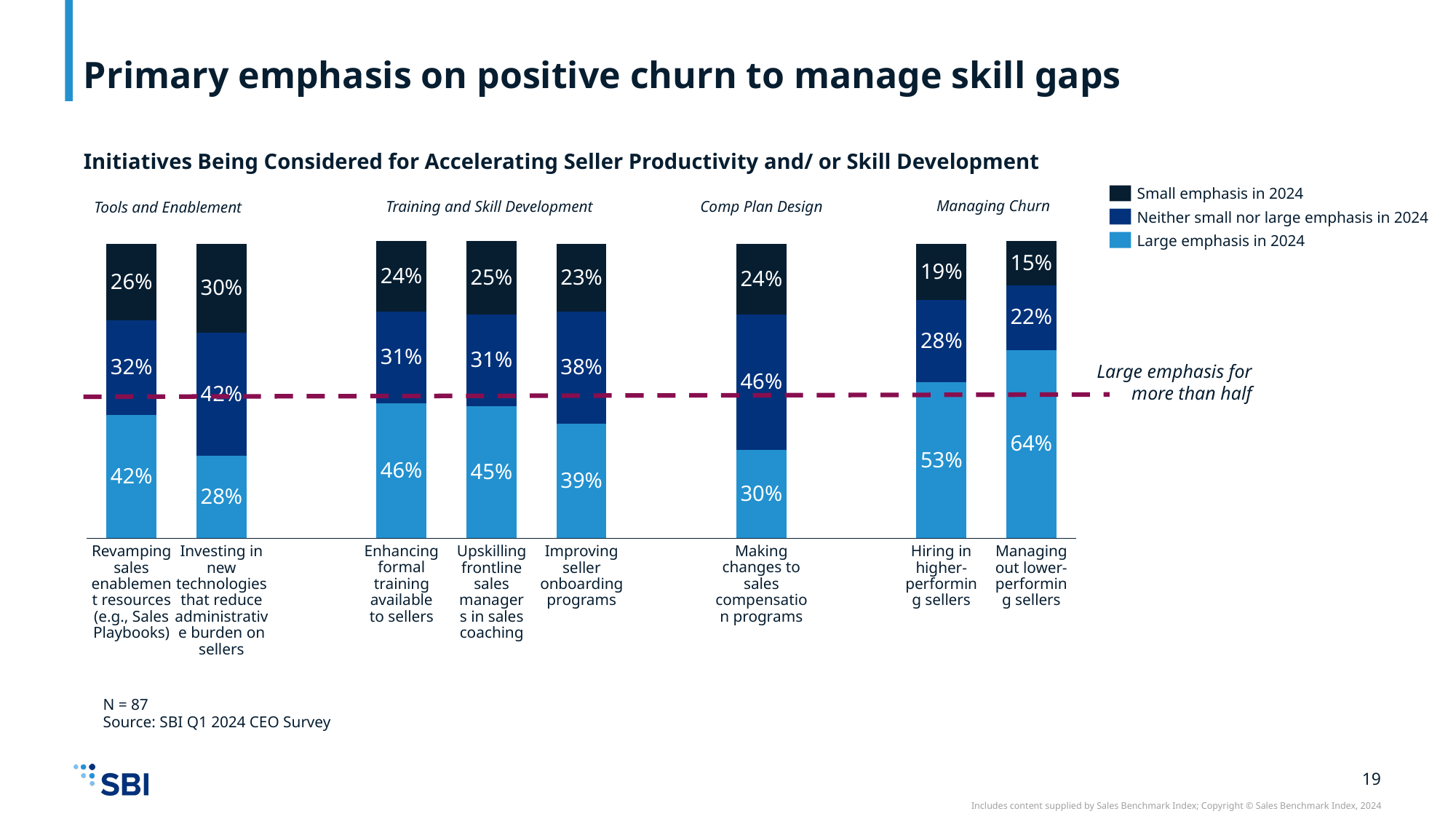
How many initiatives (bars) are shown in the chart? 8 What is the 'Small emphasis in 2024' value for Investing in new technologies that reduce administrative burden on sellers? 30% Which initiative has the highest 'Large emphasis in 2024' value? Managing out lower-performing sellers What does the dashed horizontal line across the chart indicate? Large emphasis for more than half What is the 'Large emphasis in 2024' value for Managing out lower-performing sellers? 64% What kind of chart is shown on the slide? Stacked bar chart What is the 'Neither small nor large emphasis in 2024' value for Making changes to sales compensation programs? 46% What is the total of the stacked bar for Upskilling frontline sales managers in sales coaching? 101% What is the difference between the 'Large emphasis in 2024' values for Hiring in higher-performing sellers and Enhancing formal training available to sellers? 7% Which initiative has the lowest 'Large emphasis in 2024' value? Investing in new technologies that reduce administrative burden on sellers How many series does the legend list? 3 Which has a larger 'Small emphasis in 2024' value: Revamping sales enablement resources or Improving seller onboarding programs? Revamping sales enablement resources